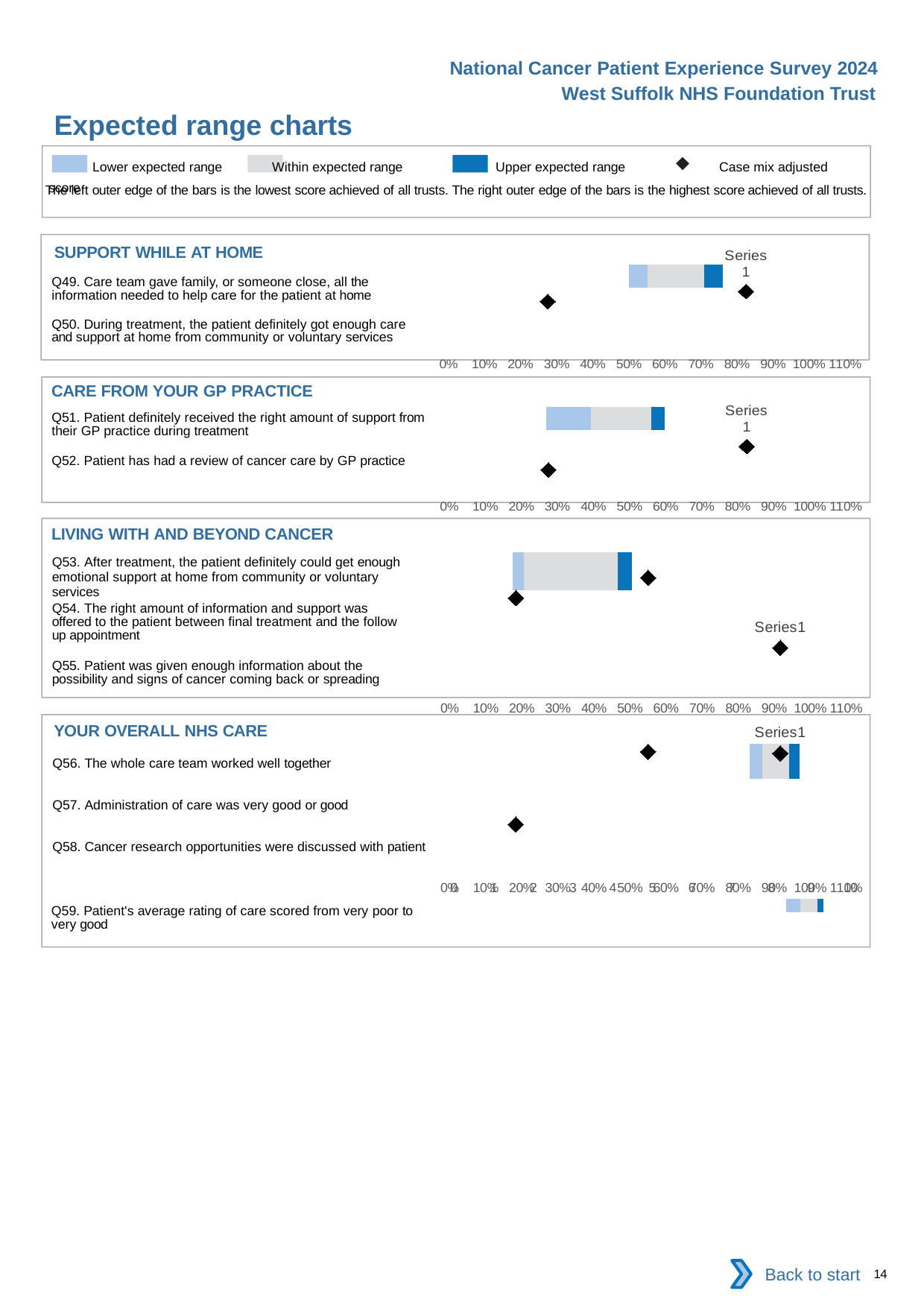
How many questions are listed in the YOUR OVERALL NHS CARE chart? 4 How many questions are listed in the SUPPORT WHILE AT HOME chart? 2 How many entries does the legend at the top of the slide list? 4 How many questions are listed in the CARE FROM YOUR GP PRACTICE chart? 2 What kind of chart is used in the Expected range charts on this slide? bar chart What is the highest percentage tick shown on the x axis of the charts? 110% In the LIVING WITH AND BEYOND CANCER chart, is the rightmost diamond marker greater or less than 80%? greater According to the legend, what does the diamond marker represent? Case mix adjusted score In the YOUR OVERALL NHS CARE chart, is the rightmost diamond marker greater or less than 80%? greater In the CARE FROM YOUR GP PRACTICE chart, is the leftmost diamond marker greater or less than 40%? less